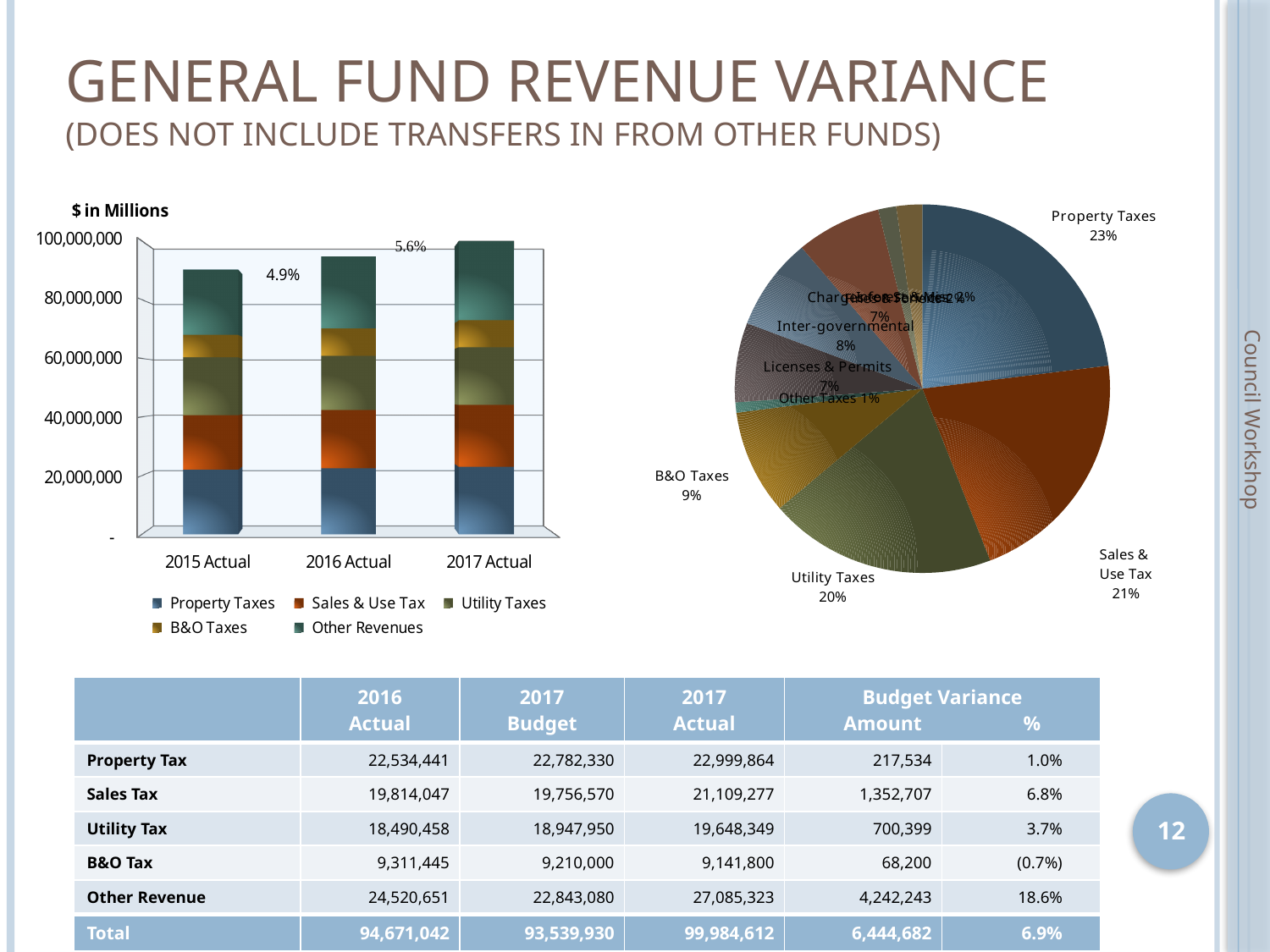
In the bar chart on the left, is the total height of the 2015 Actual bar greater or less than 80,000,000? greater In the bar chart on the left, what percentage label is shown next to the 2017 Actual bar? 5.6% What kind of chart is the chart on the right of the slide? pie chart In the pie chart on the right, which is larger, Sales & Use Tax or Utility Taxes? Sales & Use Tax In the bar chart on the left, do the total bar heights rise or fall from 2015 Actual to 2017 Actual? rise In the bar chart on the left, how many categories are shown on the x axis? 3 In the pie chart on the right, what share is shown for Property Taxes? 23% In the bar chart on the left, is the total height of the 2015 Actual bar greater or less than 100,000,000? less In the pie chart on the right, which slice is the largest? Property Taxes In the bar chart on the left, how many series does the legend list? 5 What kind of chart is the chart on the left of the slide? bar chart